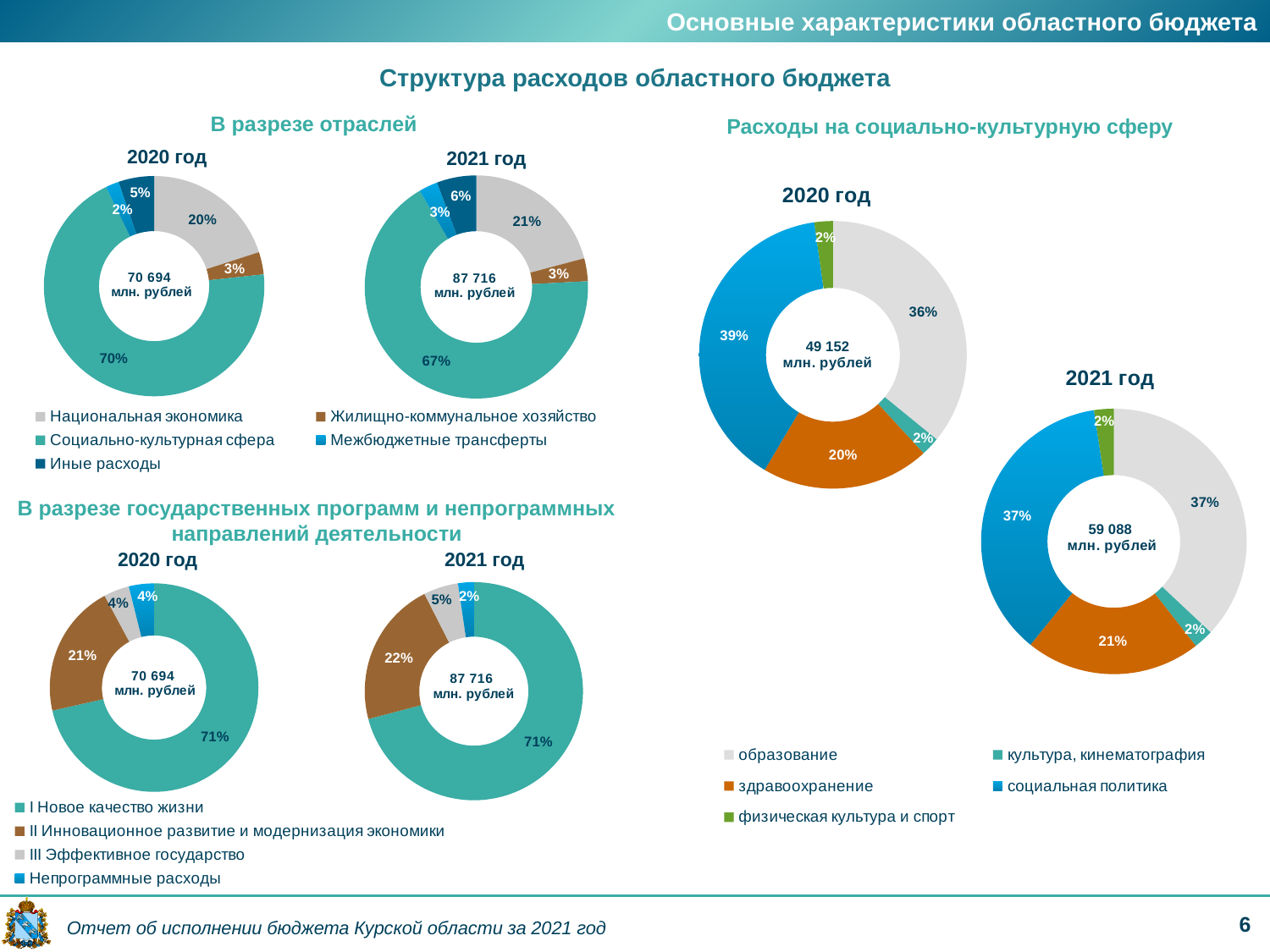
In the 'Расходы на социально-культурную сферу' 2020 год chart, which category has the largest share? социальная политика In the 'Расходы на социально-культурную сферу' 2020 год chart, what share is labelled for социальная политика? 39% In the 'В разрезе отраслей' 2020 год chart, which category has the smallest share? Межбюджетные трансферты In the 'В разрезе отраслей' 2020 год chart, what share is labelled for Социально-культурная сфера? 70% In the 'В разрезе государственных программ' 2020 год chart, which is larger: the share for I Новое качество жизни or for II Инновационное развитие и модернизация экономики? I Новое качество жизни What total amount is shown in the centre of the 'В разрезе отраслей' 2021 год chart? 87 716 млн. рублей How many entries does the legend of the 'Расходы на социально-культурную сферу' charts list? 5 In the 'В разрезе отраслей' 2021 год chart, what share is labelled for Национальная экономика? 21% In the 'В разрезе государственных программ' 2021 год chart, what share is labelled for II Инновационное развитие и модернизация экономики? 22% What type of chart is used for the 'В разрезе отраслей' 2020 год chart? Pie (donut) chart What total amount is shown in the centre of the 'Расходы на социально-культурную сферу' 2021 год chart? 59 088 млн. рублей In the 'Расходы на социально-культурную сферу' 2021 год chart, what is the difference between the shares for образование and здравоохранение? 16%